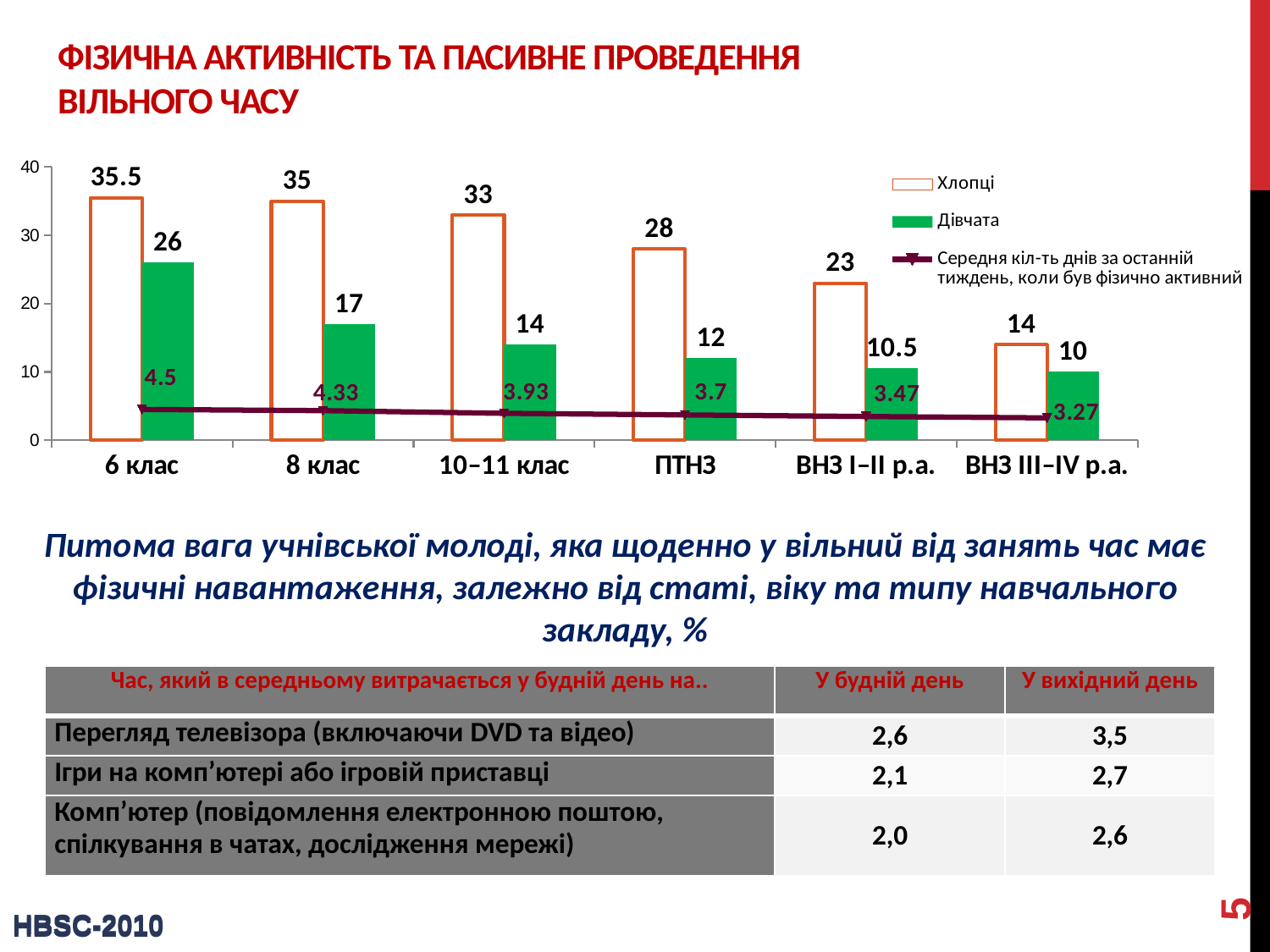
What is the difference between the Хлопці and Дівчата values in the 8 клас category? 18 Do the values of the line series rise or fall from 6 клас to ВНЗ III–IV р.а.? fall What colour are the bars for Дівчата? green Is the value for Хлопці in the ПТНЗ category greater or less than 20? greater Which category has the lowest value for Дівчата? ВНЗ III–IV р.а. How many categories are shown on the x axis? 6 What is the value for Хлопці in the 6 клас category? 35.5 Which category has the highest value for Хлопці? 6 клас Which is larger in the ВНЗ I–II р.а. category: the value for Хлопці or for Дівчата? Хлопці What is the value for Дівчата in the ПТНЗ category? 12 How many series does the legend list? 3 What is the value of the line series (Середня кіл-ть днів за останній тиждень, коли був фізично активний) for 10–11 клас? 3.93